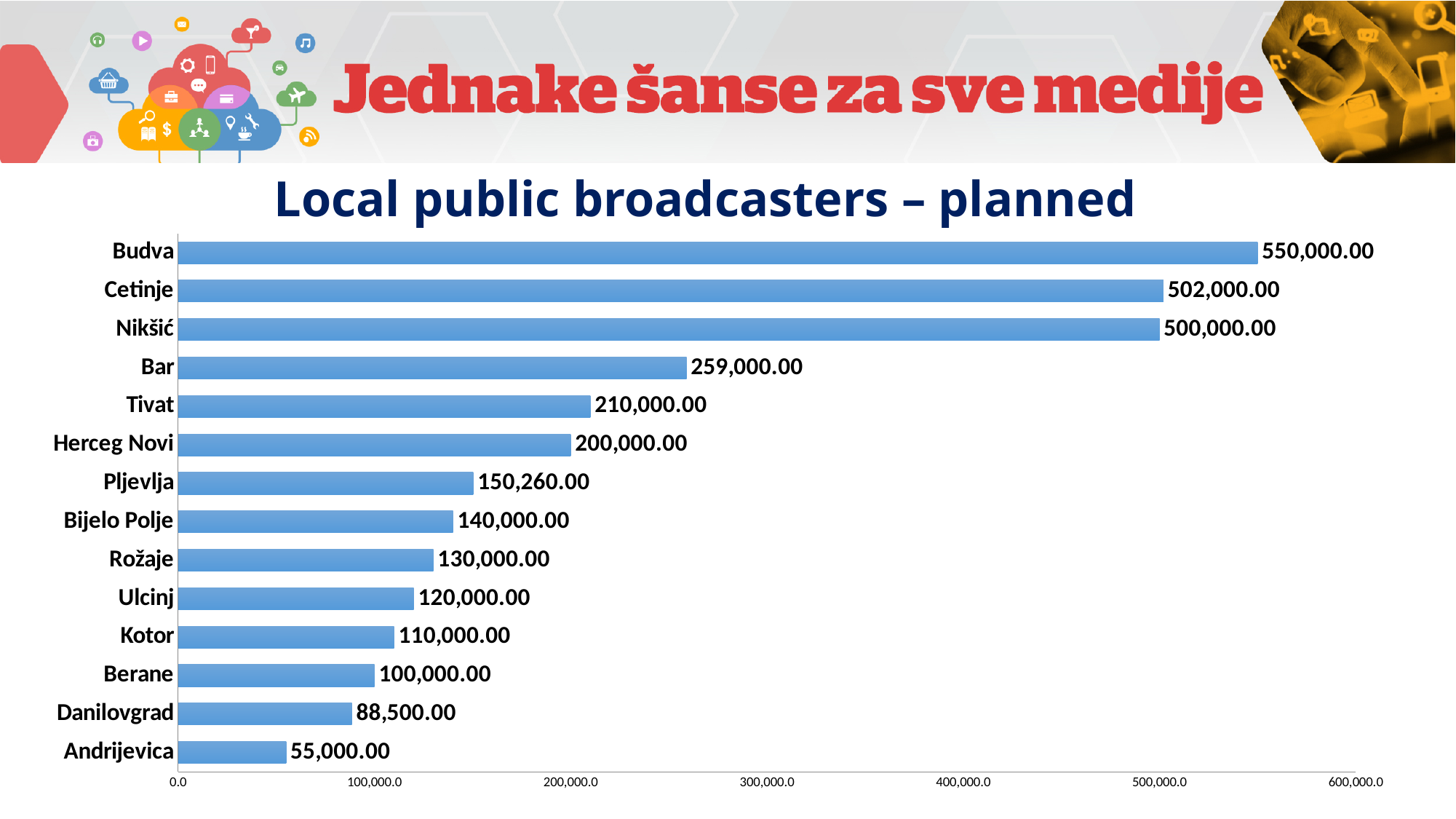
Which local public broadcaster has the highest planned value? Budva What is the difference between the planned values for Budva and Nikšić? 50,000.00 Which local public broadcaster has the lowest planned value? Andrijevica What kind of chart is shown on the slide? bar chart What is the difference between the planned values for Bar and Tivat? 49,000.00 Which has a larger planned value, Herceg Novi or Bar? Bar What is the planned value for Budva? 550,000.00 What is the planned value for Danilovgrad? 88,500.00 What is the title of the chart? Local public broadcasters – planned What is the planned value for Pljevlja? 150,260.00 How many local public broadcasters are shown in the chart? 14 Is the planned value for Rožaje greater or less than 200,000.0? less